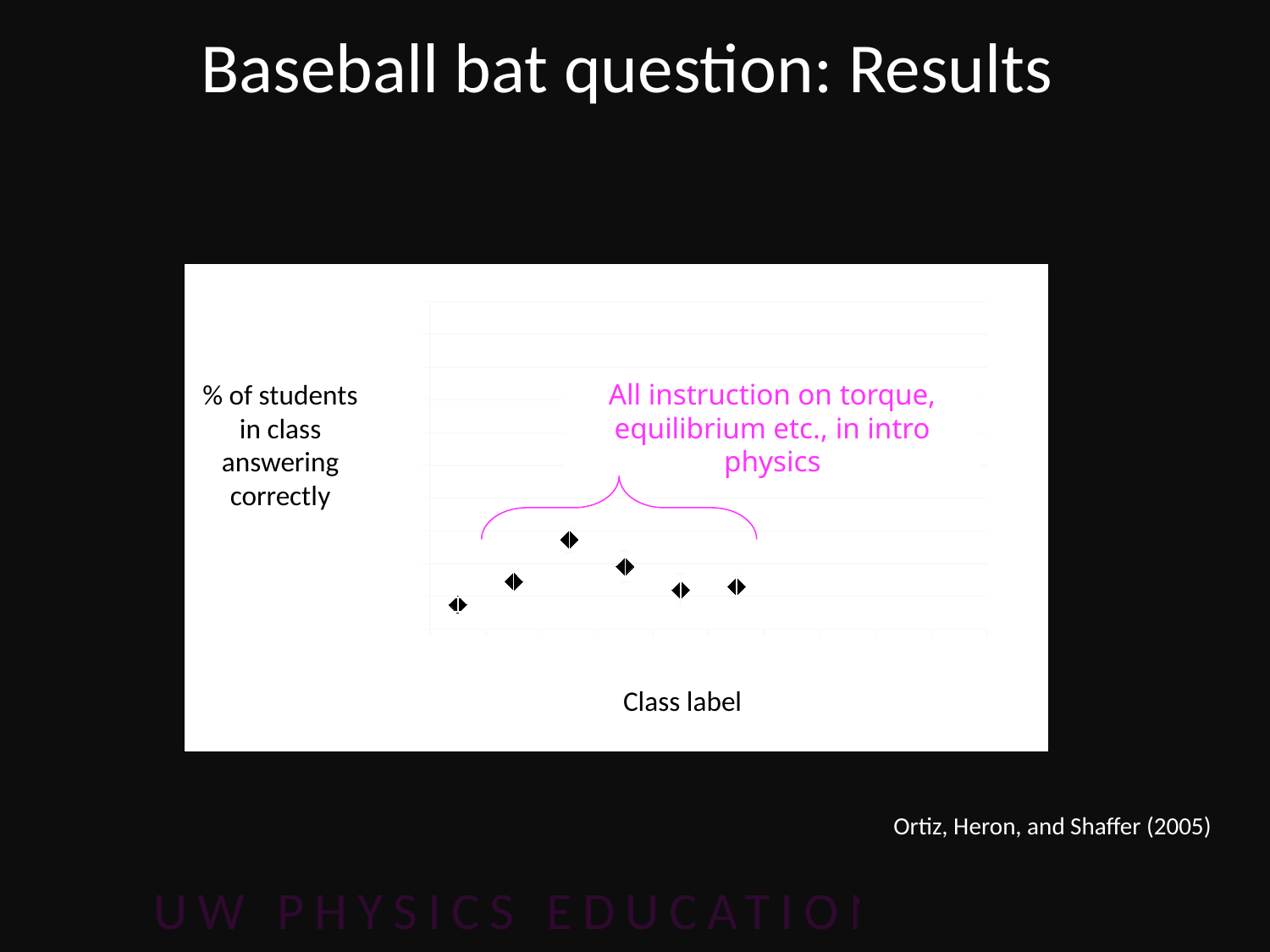
What is the label on the vertical axis of the chart? % of students in class answering correctly Counting from the left, which plotted point has the highest value? the third point What is the label on the horizontal axis of the chart? Class label Counting from the left, which plotted point has the lowest value? the first point What kind of chart is shown on the slide? scatter chart How many data points are plotted on the chart? 6